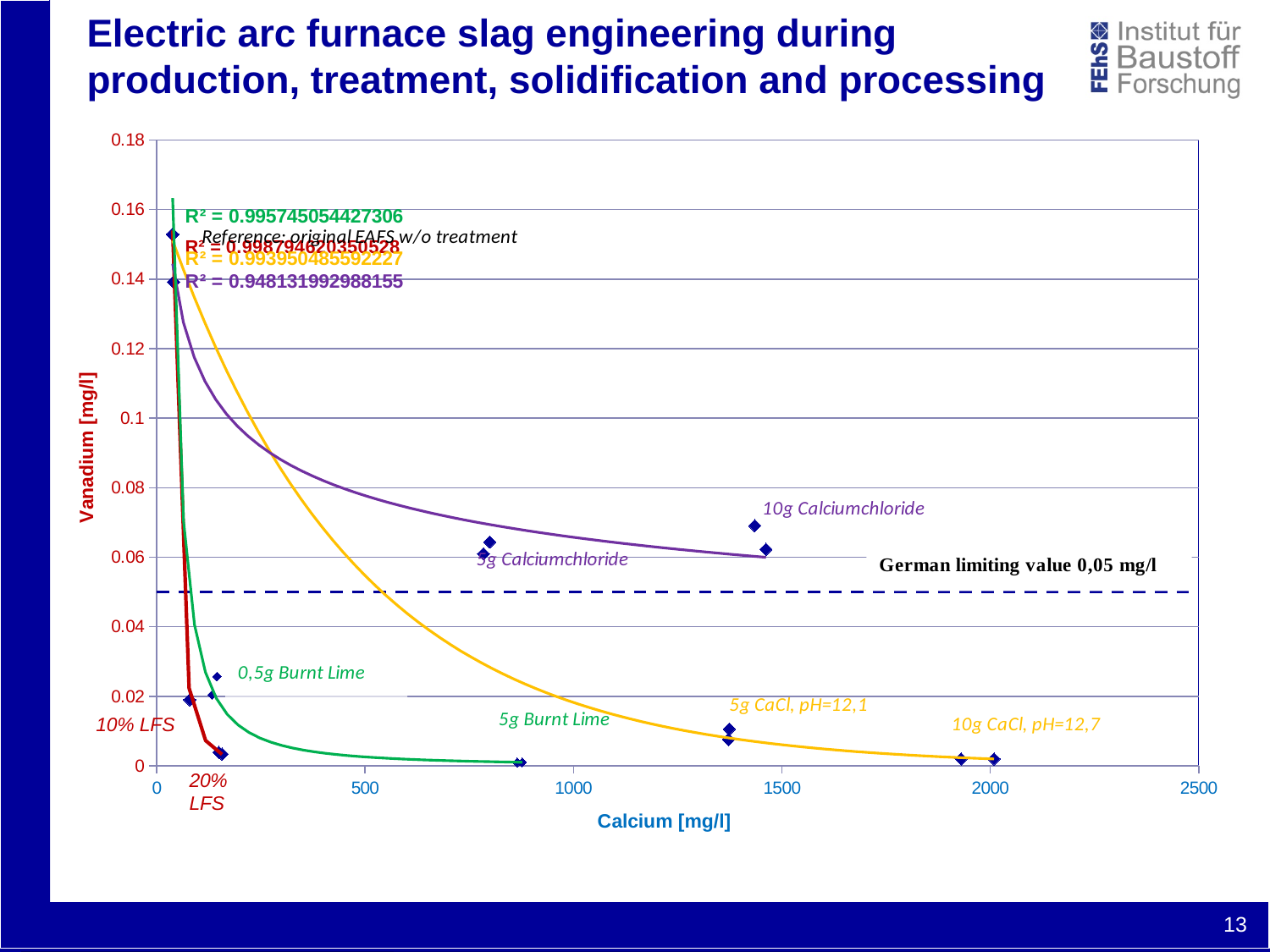
Is the vanadium value for the 5g Burnt Lime point greater or less than 0.02 mg/l? less As calcium increases along the x axis, do the fitted vanadium curves rise or fall? fall How many R² values are printed on the chart? 4 What kind of chart is shown on the slide? scatter chart What is the R² value printed in purple for the calcium chloride trend line? 0.948131992988155 Is the vanadium value for the 10g CaCl, pH=12,7 point greater or less than 0.02 mg/l? less Which has the higher vanadium value, the 10g Calciumchloride point or the 5g Burnt Lime point? 10g Calciumchloride What is the German limiting value marked by the dashed line? 0,05 mg/l What is the label of the x axis? Calcium [mg/l] What is the label of the y axis? Vanadium [mg/l] What is the R² value printed in green for the burnt lime trend line? 0.995745054427306 Is the vanadium value for the 10g Calciumchloride point greater or less than 0.06 mg/l? greater